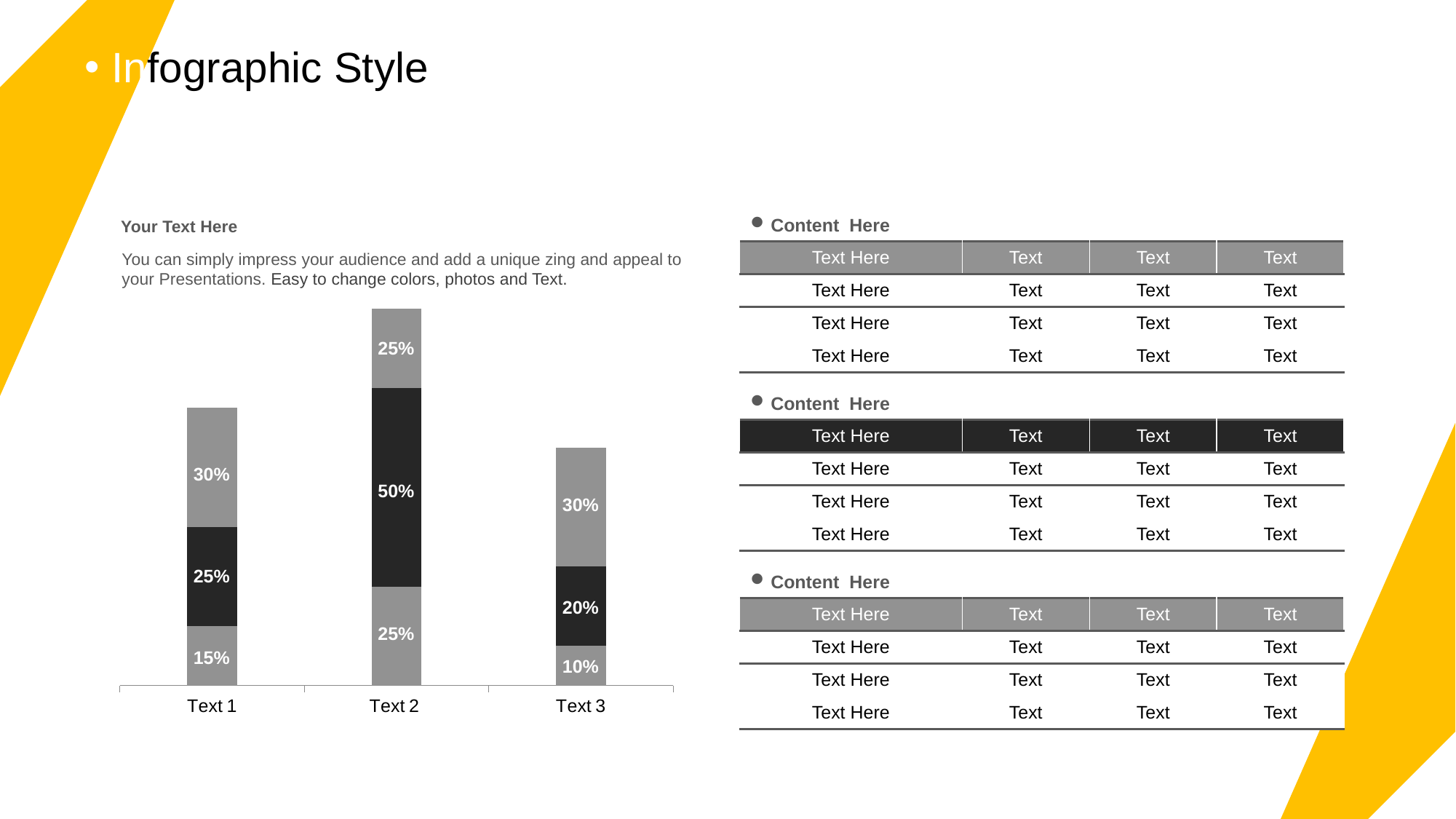
Which category has the shortest stacked bar? Text 3 What is the total of the stacked bar for Text 1? 70% What is the value of the middle (dark) segment of the Text 2 bar? 50% What is the value of the bottom segment of the Text 1 bar? 15% What is the difference between the middle (dark) segment of Text 2 and the middle (dark) segment of Text 3? 30% What is the total of the stacked bar for Text 3? 60% What is the value of the top segment of the Text 3 bar? 30% What kind of chart is shown on the slide? stacked bar chart Which category has the tallest stacked bar? Text 2 What is the total of the stacked bar for Text 2? 100% How many categories are shown on the x axis of the bar chart? 3 What is the value of the bottom segment of the Text 3 bar? 10%